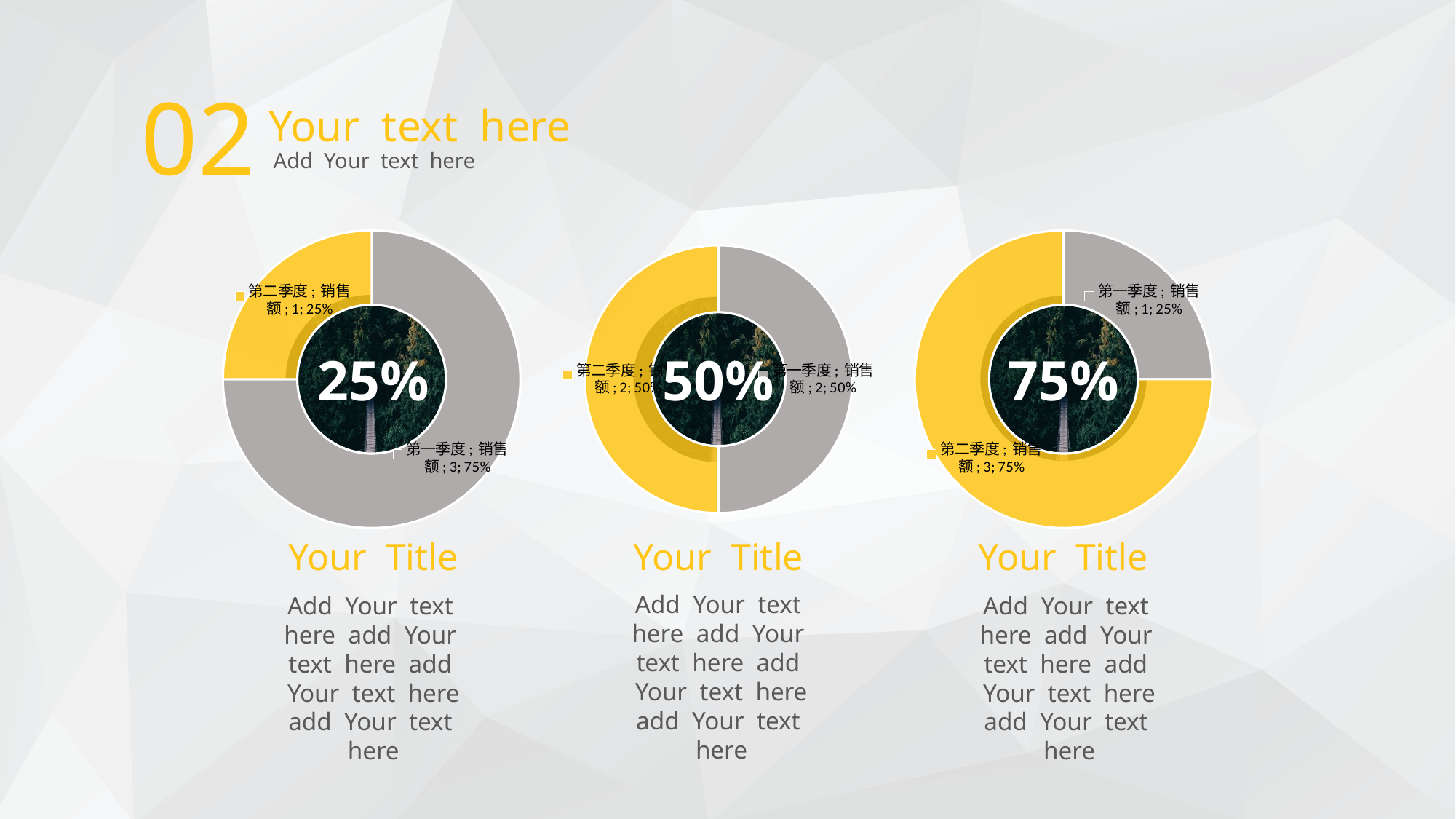
In the right chart (labelled 75% in the centre), what is the value for 第一季度? 1 In the left chart (labelled 25% in the centre), what is the value for 第一季度? 3 What kind of chart is the left chart (labelled 25% in the centre)? doughnut chart In the right chart (labelled 75% in the centre), what is the difference between the values for 第二季度 and 第一季度? 2 In the right chart (labelled 75% in the centre), which category has the smallest slice? 第一季度 In the left chart (labelled 25% in the centre), what share does 第一季度 have? 75% In the left chart (labelled 25% in the centre), which category has the largest slice? 第一季度 In the middle chart (labelled 50% in the centre), what is the value for 第一季度? 2 In the right chart (labelled 75% in the centre), what share does 第二季度 have? 75% In the middle chart (labelled 50% in the centre), what share does 第二季度 have? 50% How many slices does the middle chart (labelled 50% in the centre) have? 2